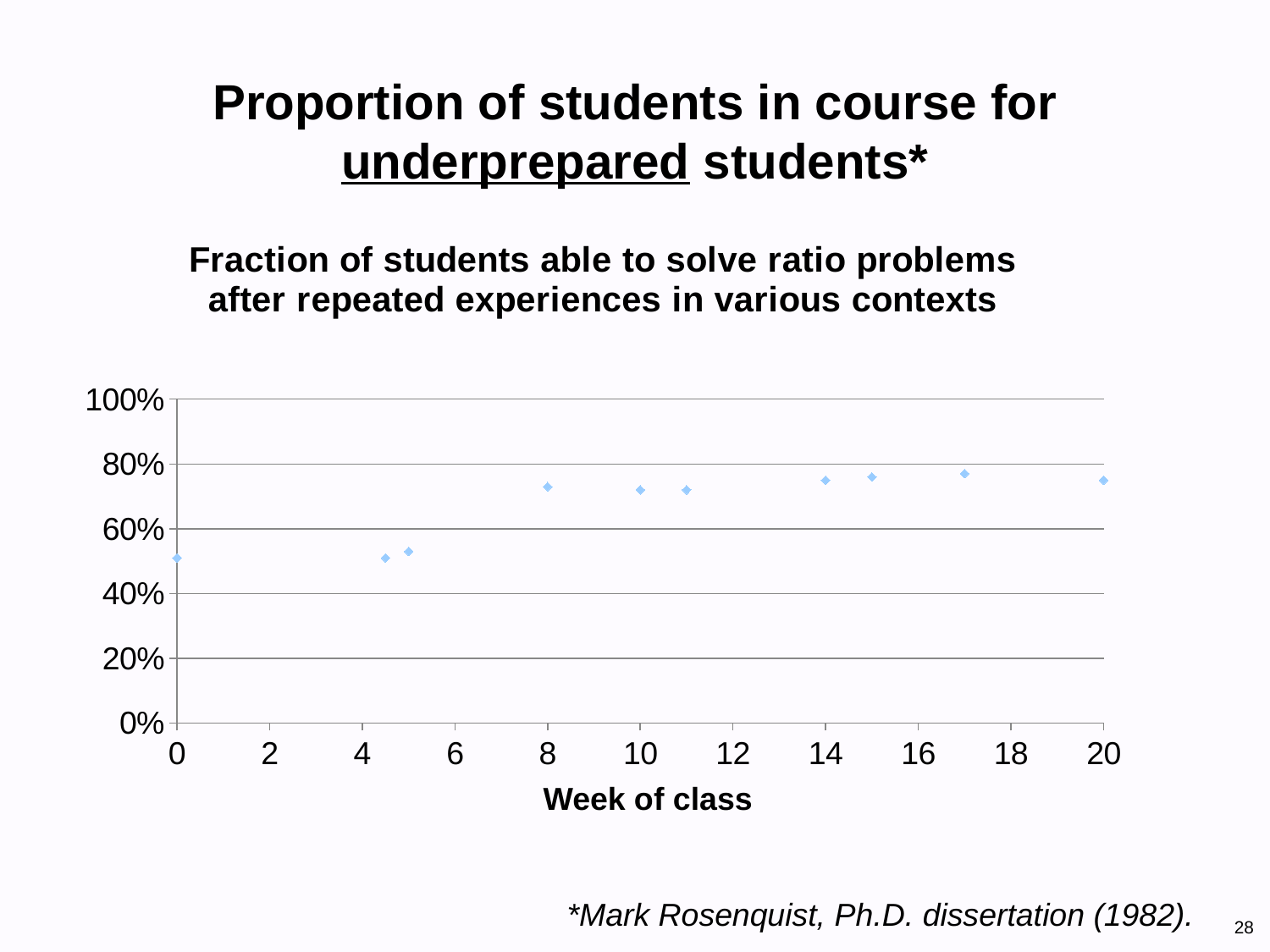
What kind of chart is shown on the slide? scatter chart Which is larger, the value at week 5 or the value at week 20? week 20 Is the value at week 17 greater or less than 80%? less How many data points are plotted on the chart? 10 Is the value at week 20 greater or less than 60%? greater Is the value at week 8 greater or less than 60%? greater What is the title of the x axis? Week of class Which is larger, the value at week 0 or the value at week 8? week 8 What is the chart's title? Fraction of students able to solve ratio problems after repeated experiences in various contexts Do the values generally rise or fall as the week of class increases? rise